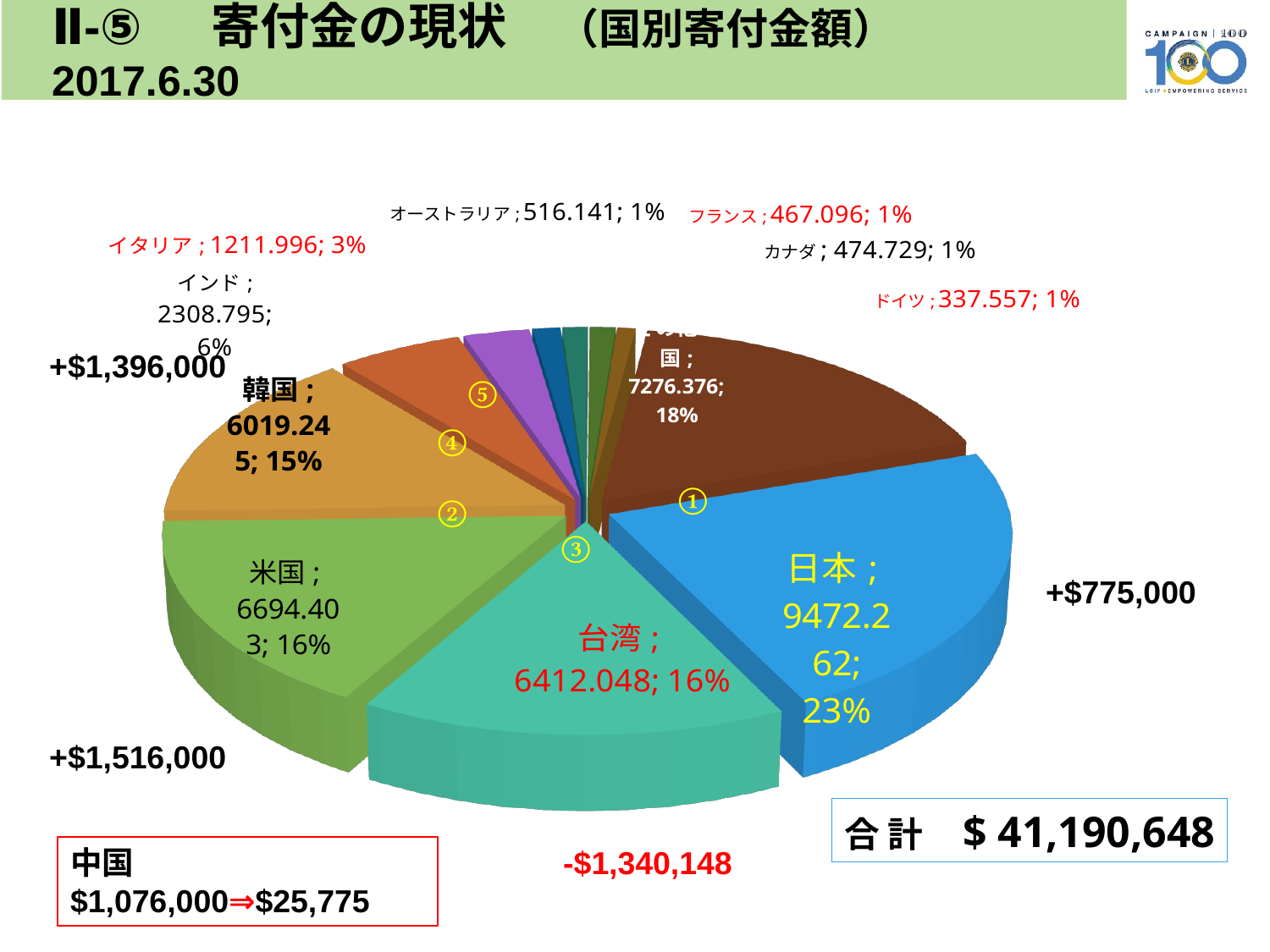
What value is shown for 韓国 in the pie chart? 6019.245 What percentage share does 日本 have in the pie chart? 23% Which country has the smallest value in the pie chart? ドイツ What is the difference between the values for 日本 and 韓国 in the pie chart? 3453.017 What value is shown for 日本 in the pie chart? 9472.262 Which country has the largest slice in the pie chart? 日本 What percentage share does インド have in the pie chart? 6% What total amount (合計) is shown on the slide? $ 41,190,648 Which has the larger value in the pie chart, 米国 or 台湾? 米国 What value is shown for 台湾 in the pie chart? 6412.048 What kind of chart is shown on the slide? pie chart What value is shown for イタリア in the pie chart? 1211.996